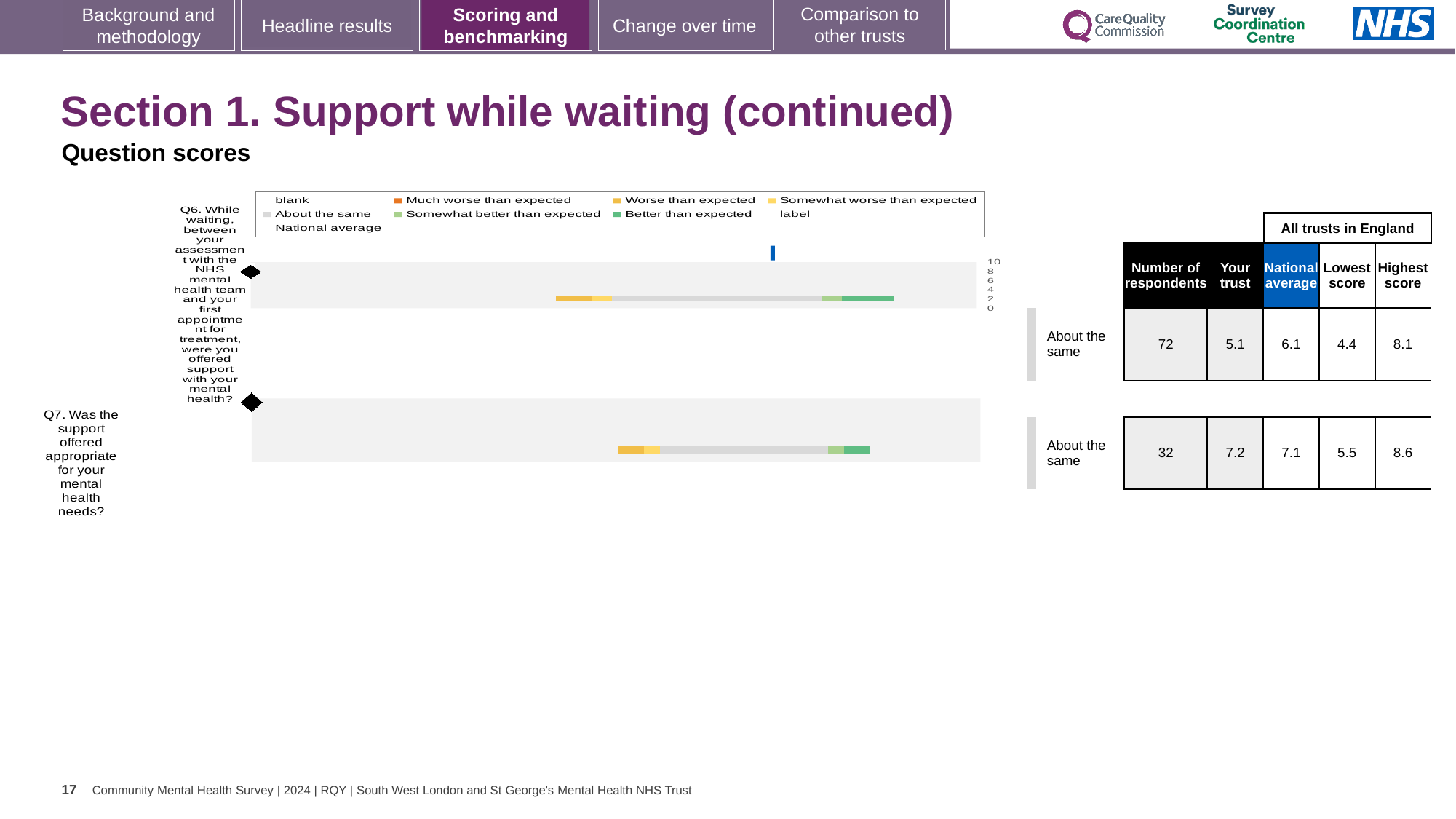
What is the national average score for Q7? 7.1 What is the difference between the national average and the trust's score for Q6? 1.0 What kind of chart is used to show the question scores on this slide? bar chart What is the difference between the highest and lowest scores for Q6? 3.7 What is the highest score among all trusts in England for Q7? 8.6 What is the lowest score among all trusts in England for Q6? 4.4 For Q6, which is larger: the trust's score or the national average? National average How many respondents answered Q6? 72 Which question has the higher 'Your trust' score, Q6 or Q7? Q7 What is the 'Your trust' score for Q6? 5.1 How many questions (categories) are plotted in the chart? 2 What benchmark category is shown for both Q6 and Q7? About the same